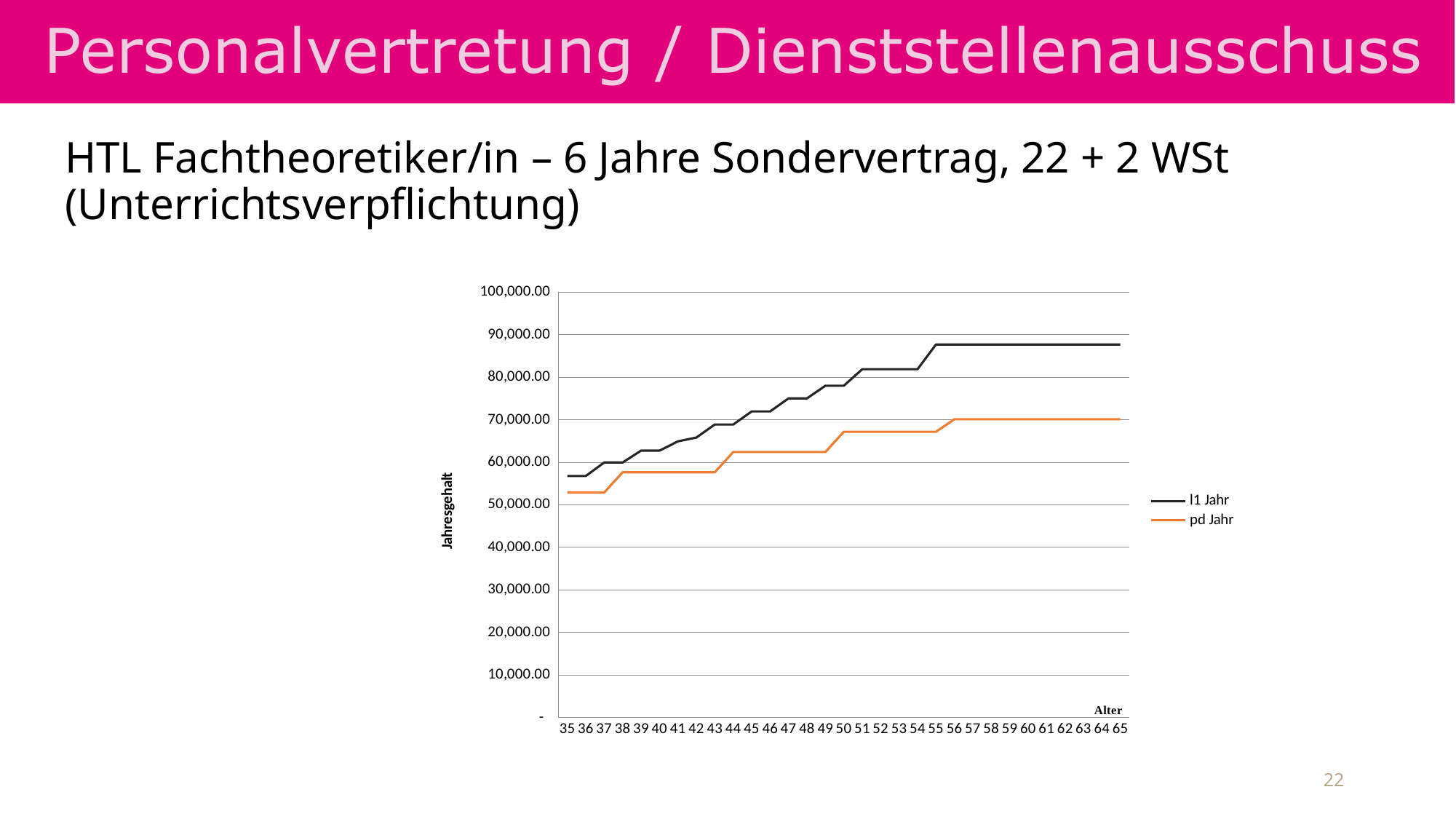
Is the value for l1 Jahr at age 65 greater or less than 80,000.00? greater How many series does the legend list? 2 Is the value for l1 Jahr at age 35 greater or less than 50,000.00? greater What is the title of the horizontal axis? Alter Does the l1 Jahr line rise or fall as age increases along the x axis? rise How many age values are shown on the x axis? 31 What kind of chart is shown on the slide? line chart At age 65, which series has the higher value, l1 Jahr or pd Jahr? l1 Jahr Is the value for pd Jahr at age 35 greater or less than 60,000.00? less What is the title of the vertical axis? Jahresgehalt At age 45, which series has the higher value, l1 Jahr or pd Jahr? l1 Jahr